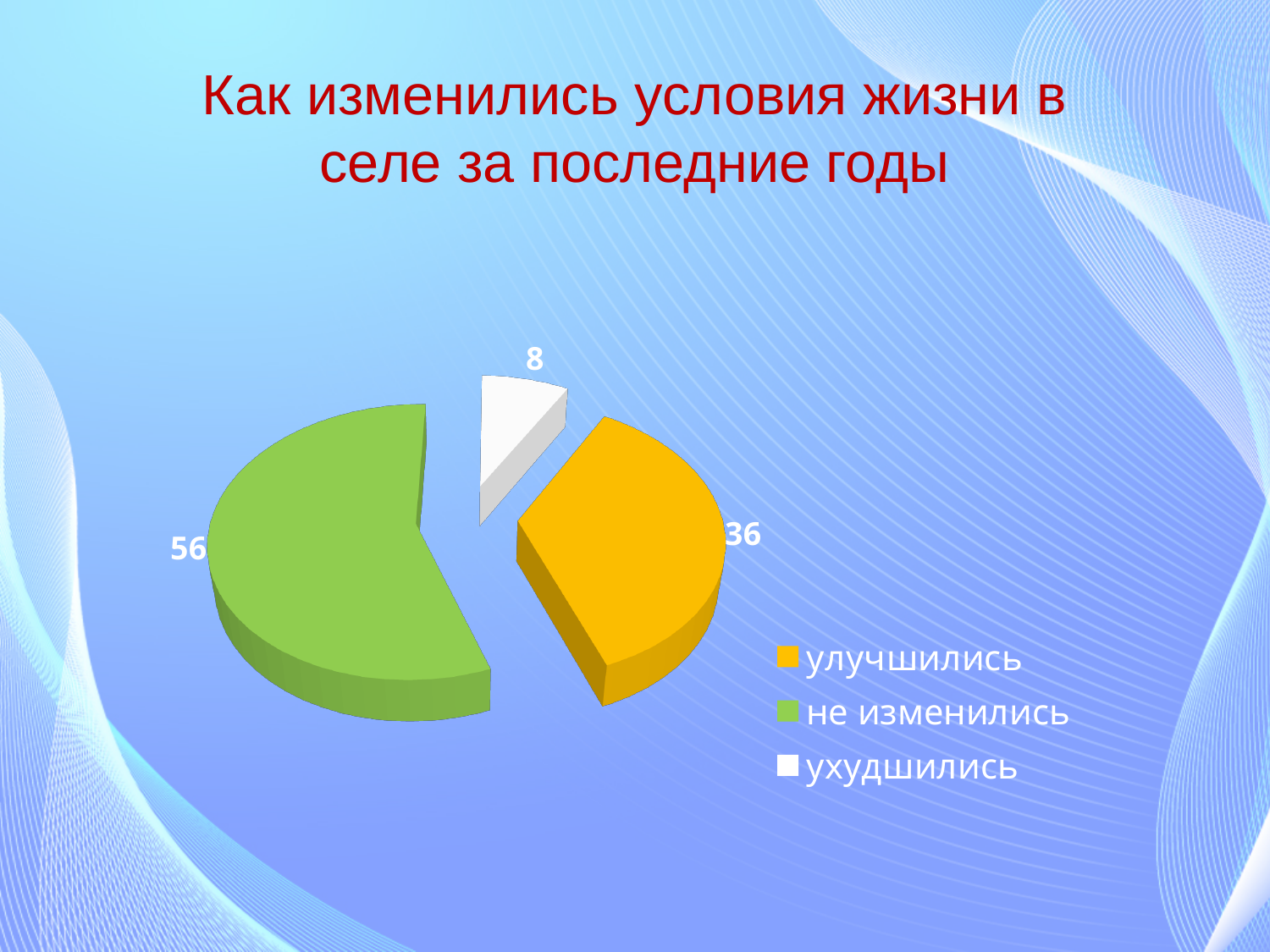
What type of chart is shown on the slide? pie chart Which category has the largest slice of the pie? не изменились What is the difference between the values for "не изменились" and "улучшились"? 20 What is the difference between the values for "улучшились" and "ухудшились"? 28 What share of the pie does "не изменились" represent? 56 What is the value for "улучшились"? 36 What is the value for "ухудшились"? 8 What colour is the slice for "улучшились"? orange Which is larger, the value for "улучшились" or the value for "ухудшились"? улучшились How many slices does the pie chart have? 3 Which category has the smallest slice of the pie? ухудшились What is the value for "не изменились"? 56